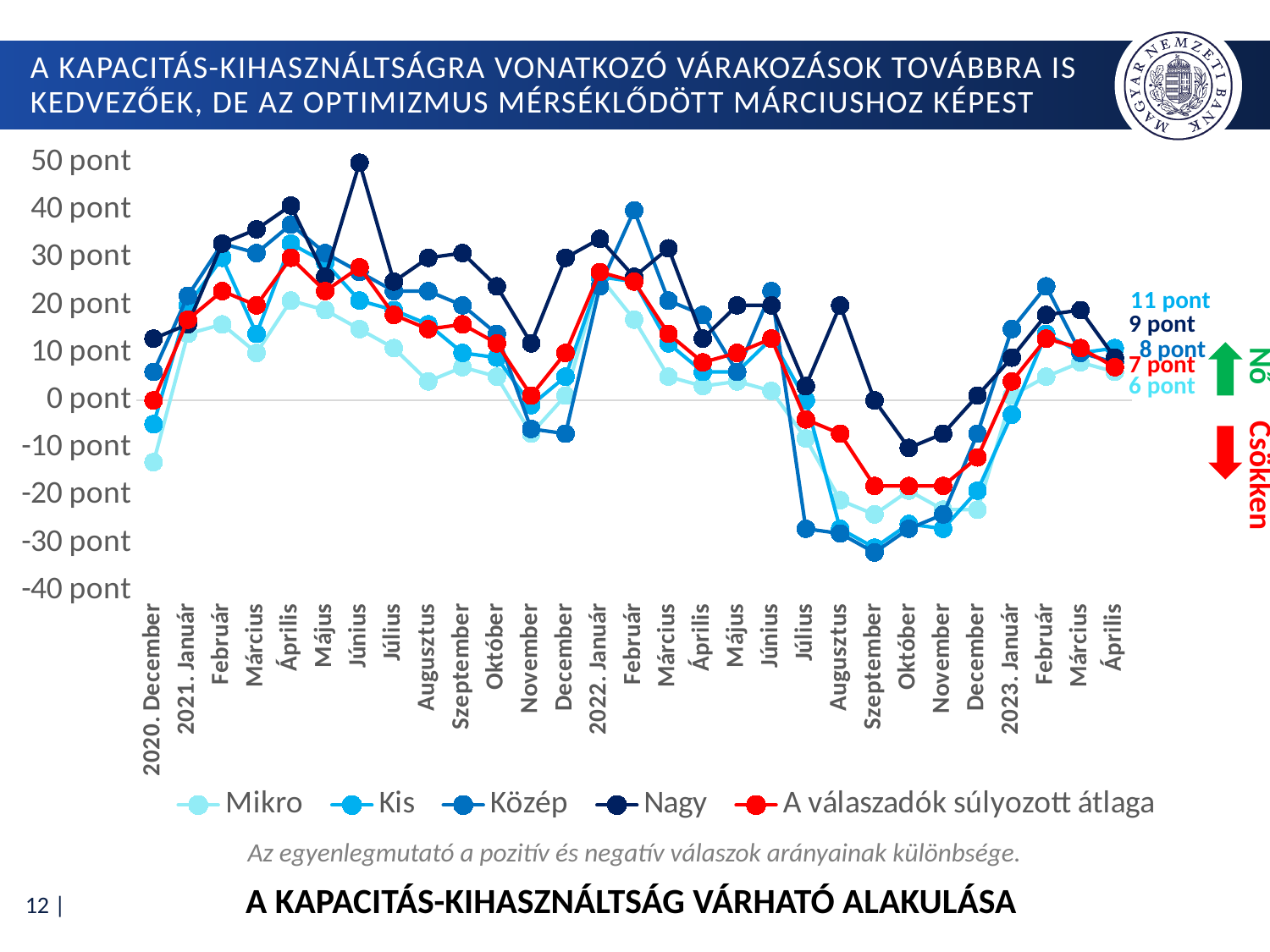
What kind of chart is shown on the slide? line chart What is the value for the Közép series in 2023 Április? 8 pont What is the value for 'A válaszadók súlyozott átlaga' in 2023 Április? 7 pont Is the value for the Nagy series in 2021 Június greater or less than 40 pont? greater What is the value for the Kis series in 2023 Április? 11 pont What is the value for the Mikro series in 2023 Április? 6 pont Which series has the highest value in 2023 Április? Kis What is the value for the Nagy series in 2023 Április? 9 pont How many months are shown on the x axis? 29 Is the value for the Közép series in 2022 Szeptember greater or less than -20 pont? less What is the difference between the Kis and Mikro values in 2023 Április? 5 pont How many series does the legend list? 5